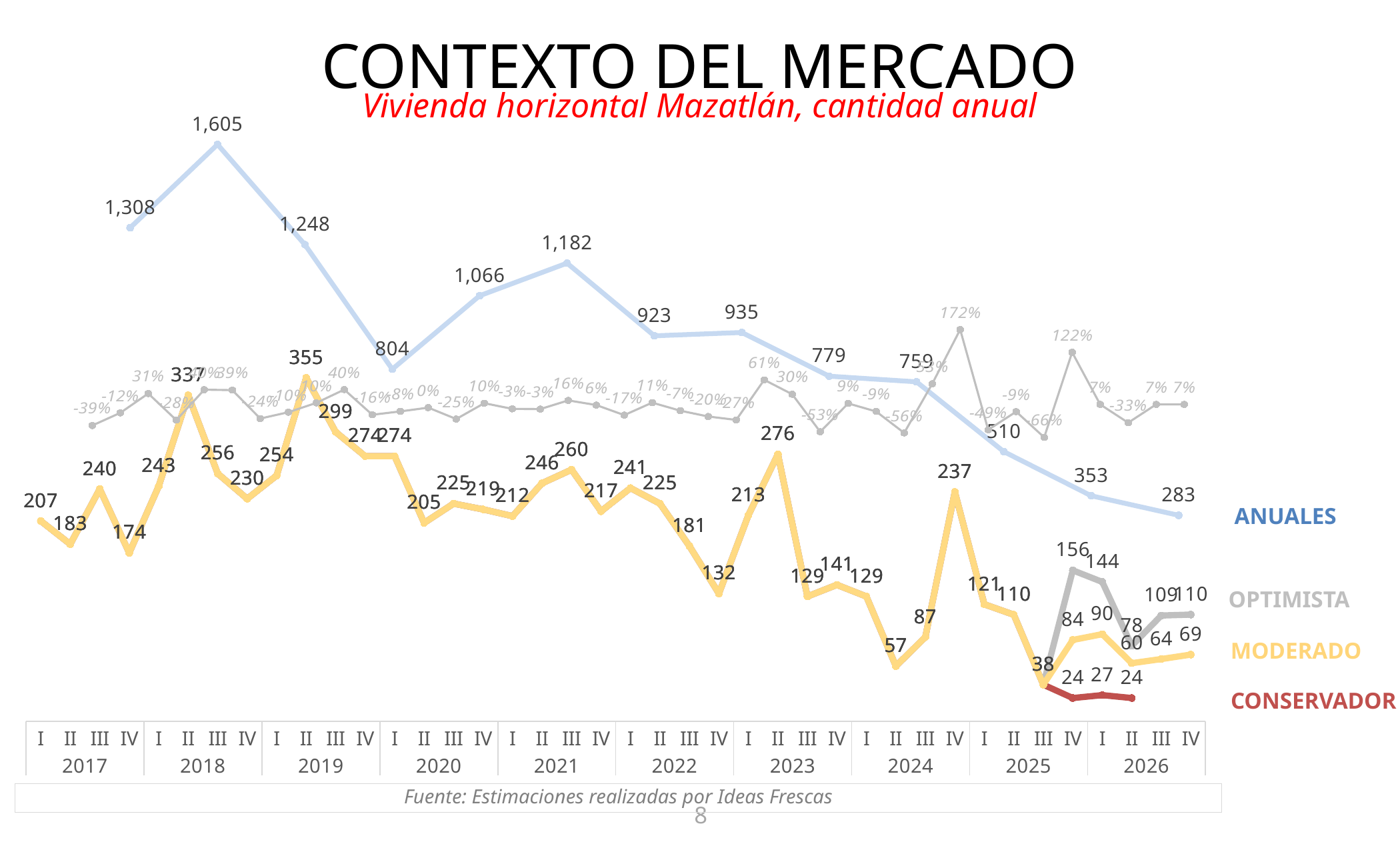
How many series does the legend on the right list? 4 What is the last labelled value on the OPTIMISTA line (2026 IV)? 110 What is the difference between the ANUALES values 1,605 and 1,248? 357 Which is larger at 2025 IV: the OPTIMISTA value (156) or the MODERADO value (84)? OPTIMISTA What is the first labelled value on the ANUALES line? 1,308 What is the highest value on the ANUALES line? 1,605 What is the lowest value on the ANUALES line? 283 What kind of chart is shown on the slide? line chart Does the ANUALES line rise or fall from 2022 to 2026? fall How many years are shown on the x axis? 10 What is the lowest value on the MODERADO line? 38 What is the highest value on the MODERADO line? 355